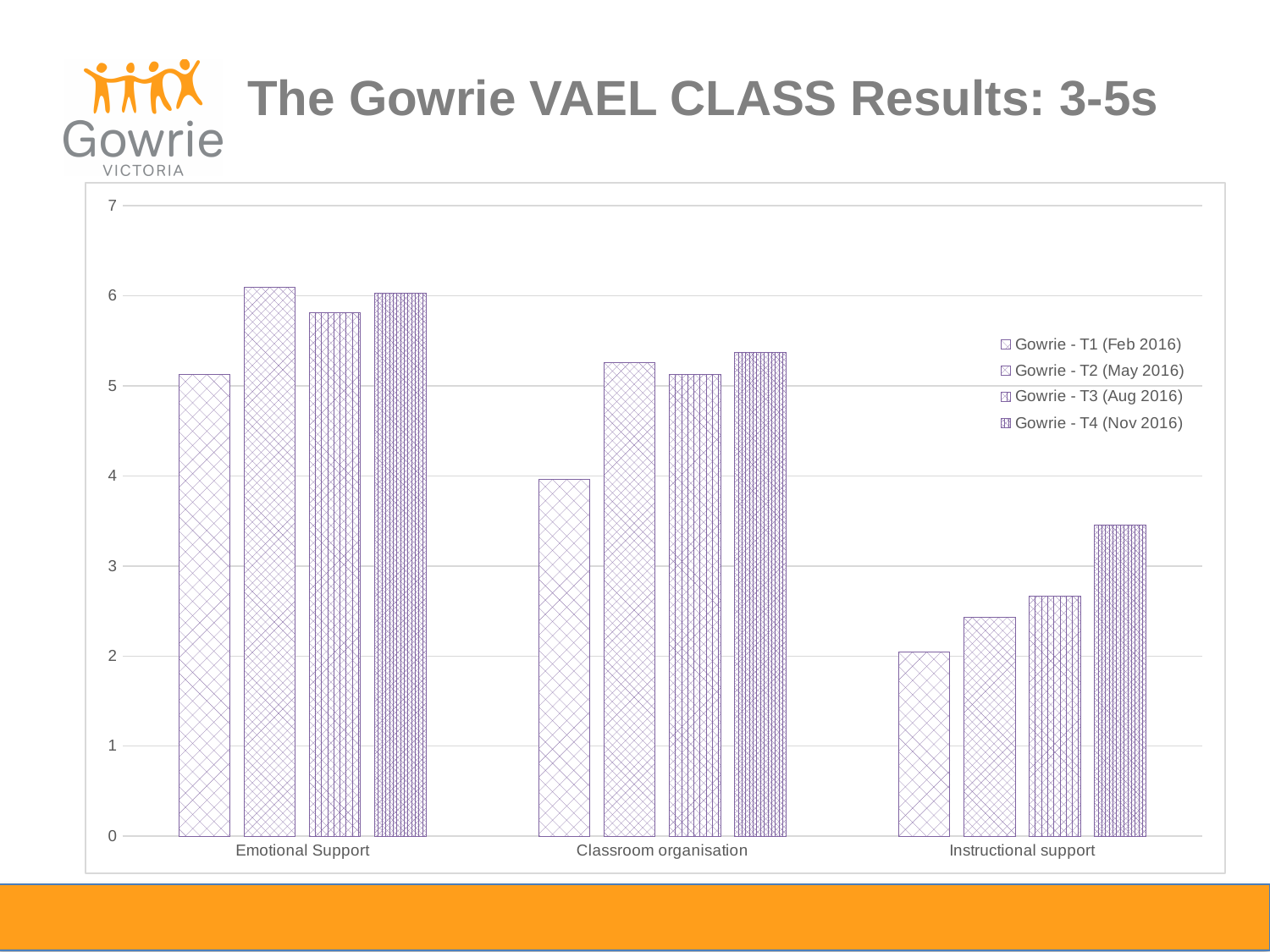
How many categories are shown on the x axis? 3 Is the value for Gowrie - T3 (Aug 2016) in Emotional Support greater or less than 6? less What kind of chart is shown on the slide? bar chart How many series does the legend list? 4 Is the value for Gowrie - T1 (Feb 2016) in Instructional support greater or less than 3? less Which series has the lowest value in Emotional Support? Gowrie - T1 (Feb 2016) Which series has the highest value in Instructional support? Gowrie - T4 (Nov 2016) Is the value for Gowrie - T1 (Feb 2016) in Classroom organisation greater or less than 3? greater Which is larger: Gowrie - T1 (Feb 2016) in Classroom organisation or Gowrie - T4 (Nov 2016) in Instructional support? Gowrie - T1 (Feb 2016) in Classroom organisation Do the values for Instructional support rise or fall from T1 to T4? rise Which series has the lowest value in Classroom organisation? Gowrie - T1 (Feb 2016)